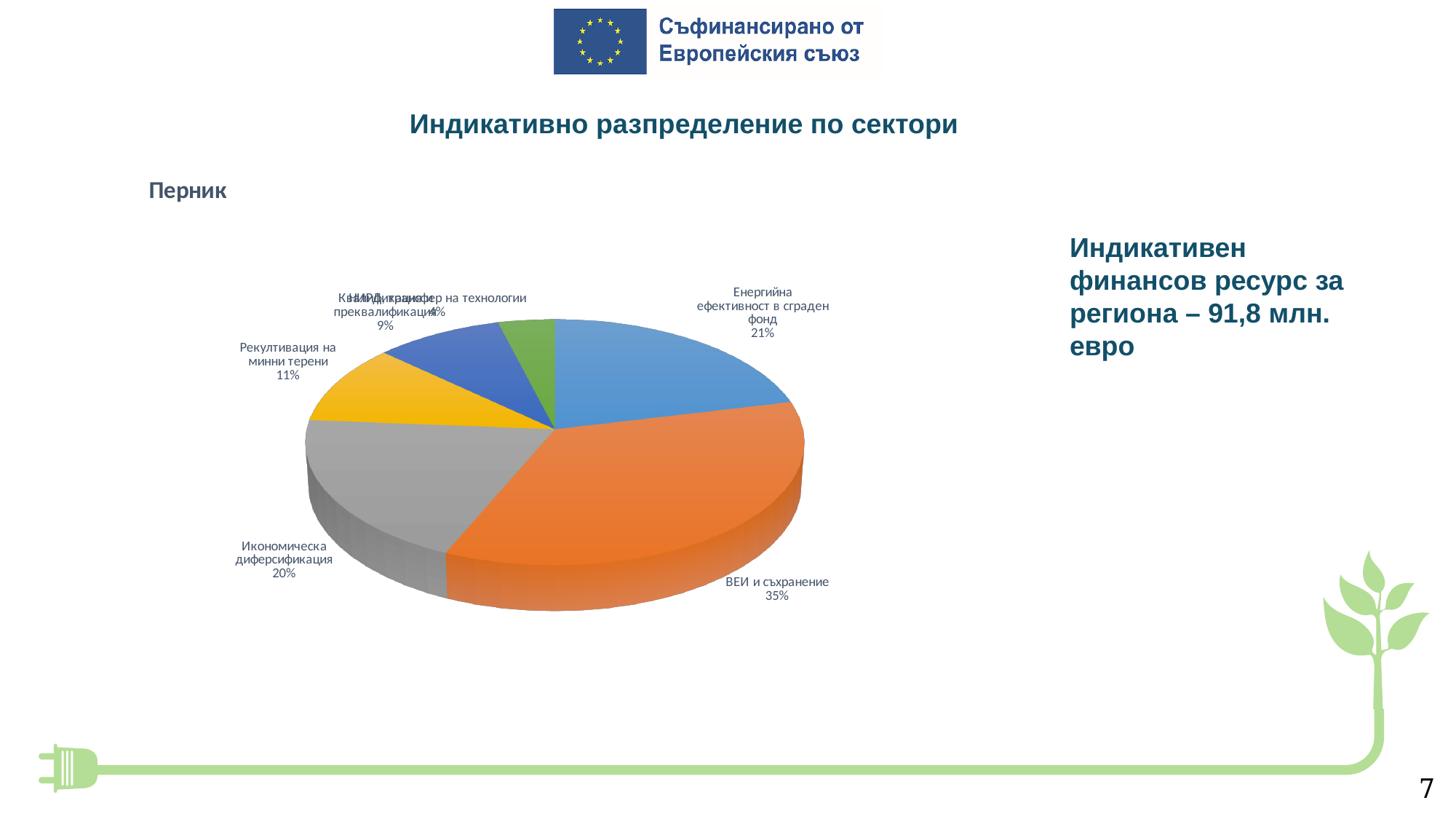
How many slices does the pie chart have? 6 Which sector has the largest share of the pie? ВЕИ и съхранение What kind of chart is shown on the slide? pie chart Which is larger: the share for "Енергийна ефективност в сграден фонд" or for "Икономическа диферсификация"? Енергийна ефективност в сграден фонд What share of the pie does "ВЕИ и съхранение" have? 35% Which region is the pie chart labelled for? Перник What percentage is shown for "Икономическа диферсификация"? 20% What percentage is shown for "Енергийна ефективност в сграден фонд"? 21% What percentage is shown for "Квалификация и преквалификация"? 9% What percentage is shown for "Рекултивация на минни терени"? 11% By how many percentage points does "ВЕИ и съхранение" exceed "Енергийна ефективност в сграден фонд"? 14 percentage points By how many percentage points does "Икономическа диферсификация" exceed "Рекултивация на минни терени"? 9 percentage points